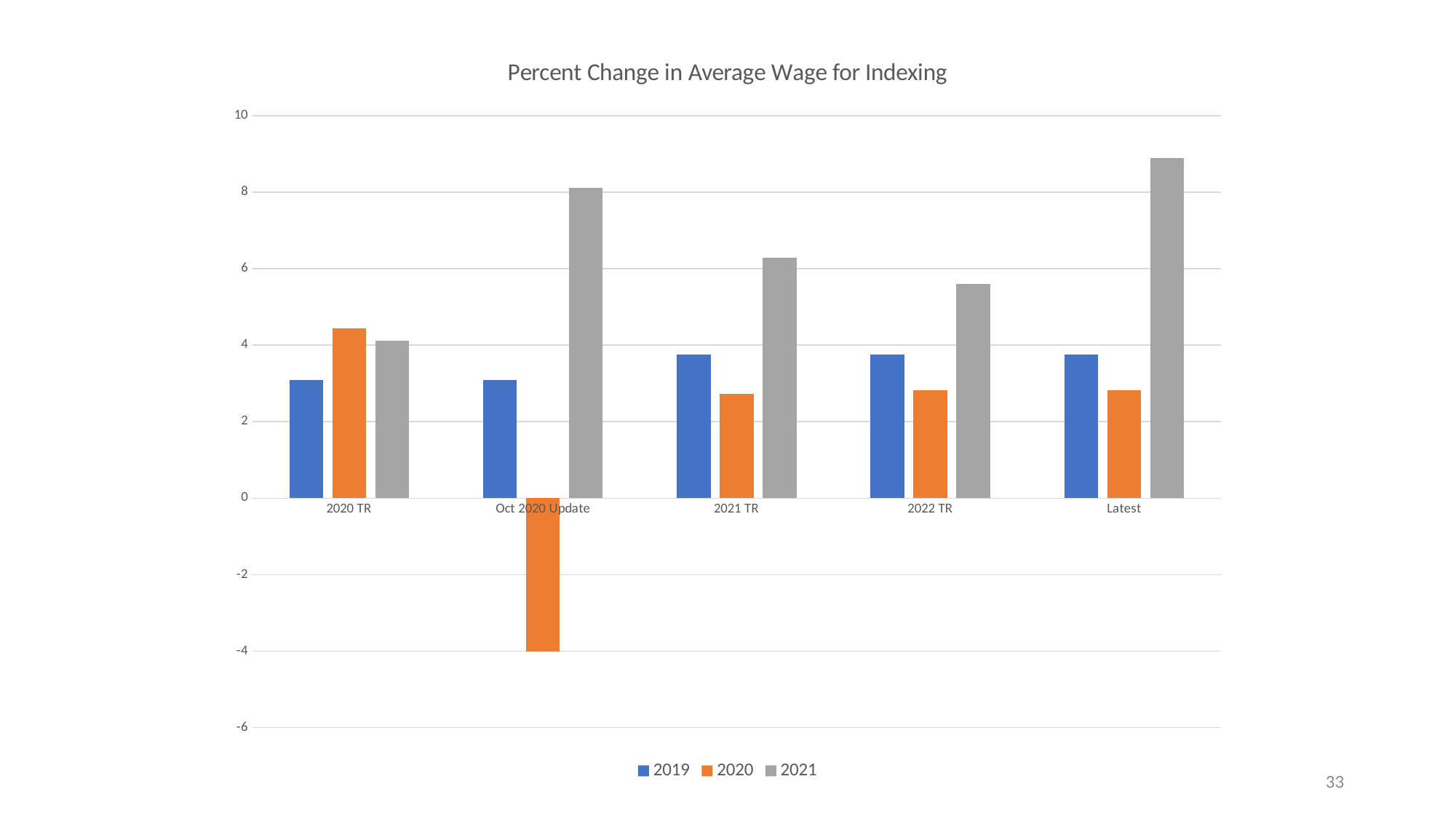
How many categories are shown on the x axis? 5 What kind of chart is shown on the slide? bar chart Which category has the highest value for the 2021 series? Latest For the 2020 TR category, which series has the larger value, 2019 or 2020? 2020 How many series does the legend list? 3 Which category has the lowest value for the 2020 series? Oct 2020 Update For the Latest category, which series has the larger value, 2019 or 2021? 2021 Is the 2021 value for Latest greater or less than 8? greater Is the 2019 value for 2021 TR greater or less than 4? less Is the 2020 value for Oct 2020 Update greater or less than 0? less What is the title of the chart? Percent Change in Average Wage for Indexing